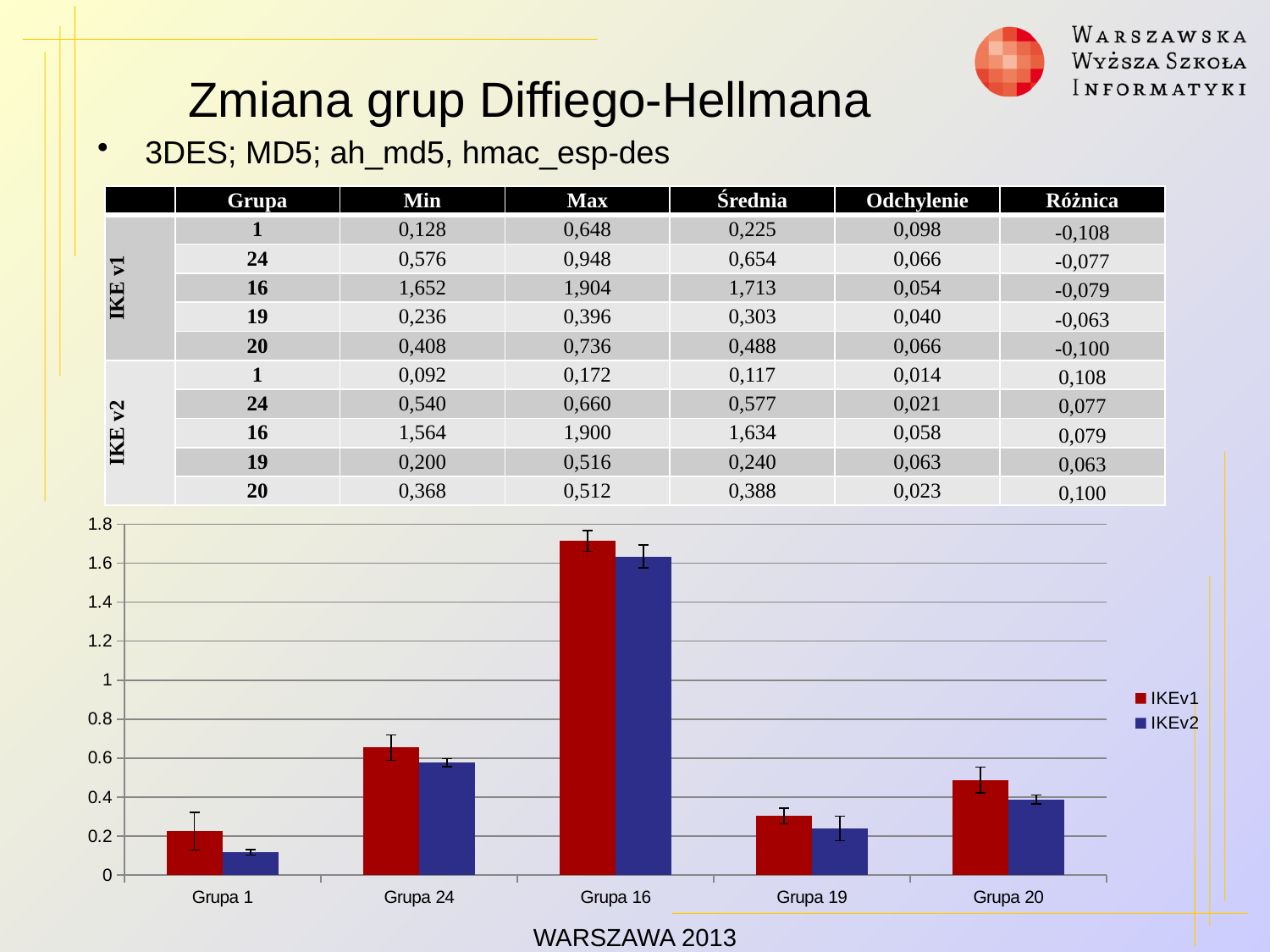
What kind of chart is shown on the slide? bar chart How many series does the chart legend list? 2 How many groups (categories) are shown on the x axis of the chart? 5 Which group has the lowest IKEv2 bar in the chart? Grupa 1 Is the IKEv1 value for Grupa 20 greater or less than 0.6? less Which is larger for IKEv1: the value for Grupa 24 or the value for Grupa 20? Grupa 24 Is the IKEv1 value for Grupa 16 greater or less than 1.6? greater Is the IKEv1 value for Grupa 24 greater or less than 0.6? greater What colour are the IKEv1 bars in the chart? red For Grupa 1, which series has the larger bar, IKEv1 or IKEv2? IKEv1 Which group has the highest IKEv1 bar in the chart? Grupa 16